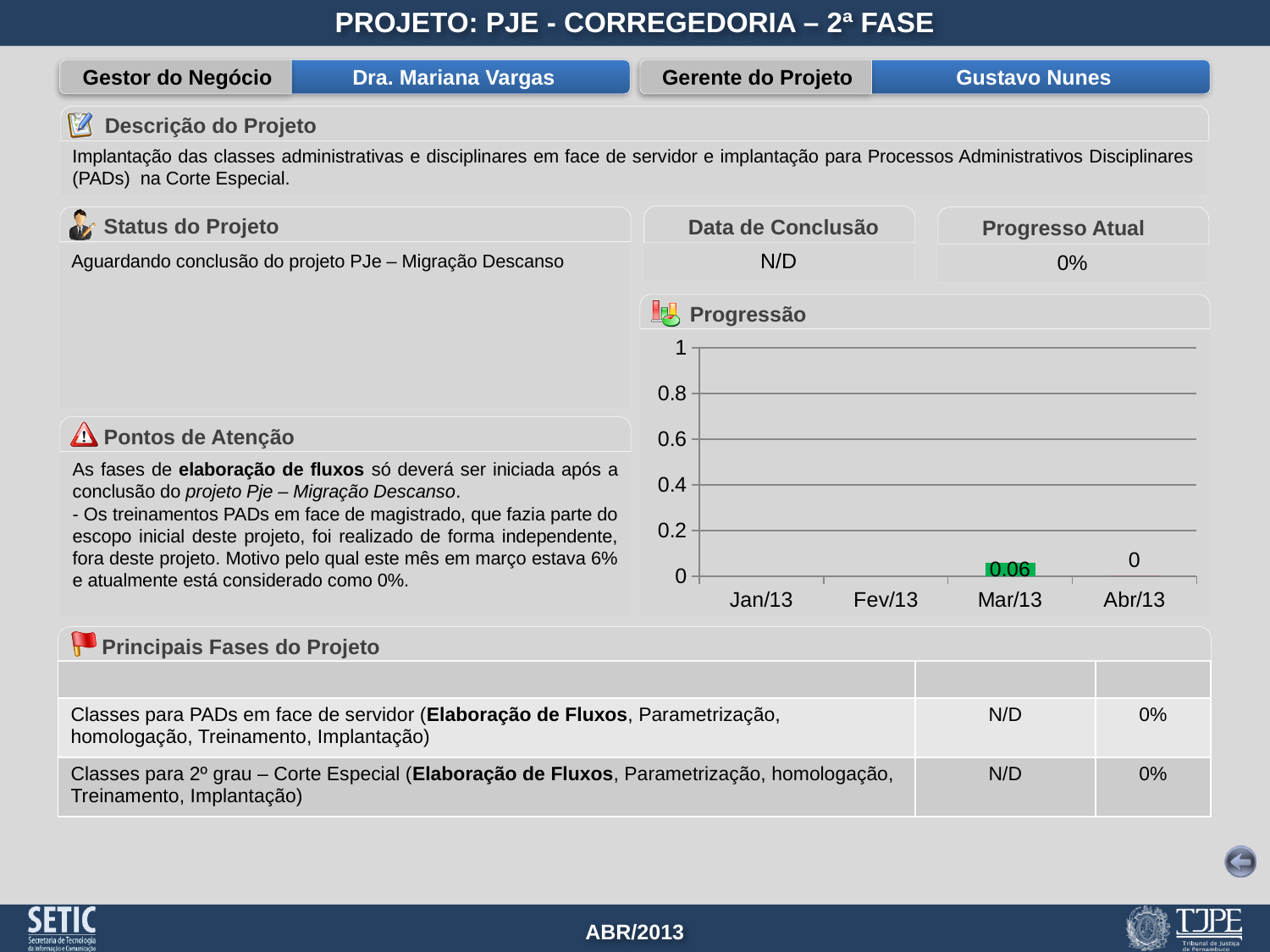
Which is larger in the Progressão chart, the value for Mar/13 or the value for Abr/13? Mar/13 What is the highest value shown on the y axis of the Progressão chart? 1 How many months are shown on the x axis of the Progressão chart? 4 Does the value rise or fall from Mar/13 to Abr/13 in the Progressão chart? fall What is the value for Mar/13 in the Progressão chart? 0.06 What is the difference between the values for Mar/13 and Abr/13 in the Progressão chart? 0.06 Which month has the highest value in the Progressão chart? Mar/13 Is the value for Mar/13 in the Progressão chart greater or less than 0.2? less What is the title of the chart on the slide? Progressão What is the value for Abr/13 in the Progressão chart? 0 What kind of chart is the Progressão chart? bar chart